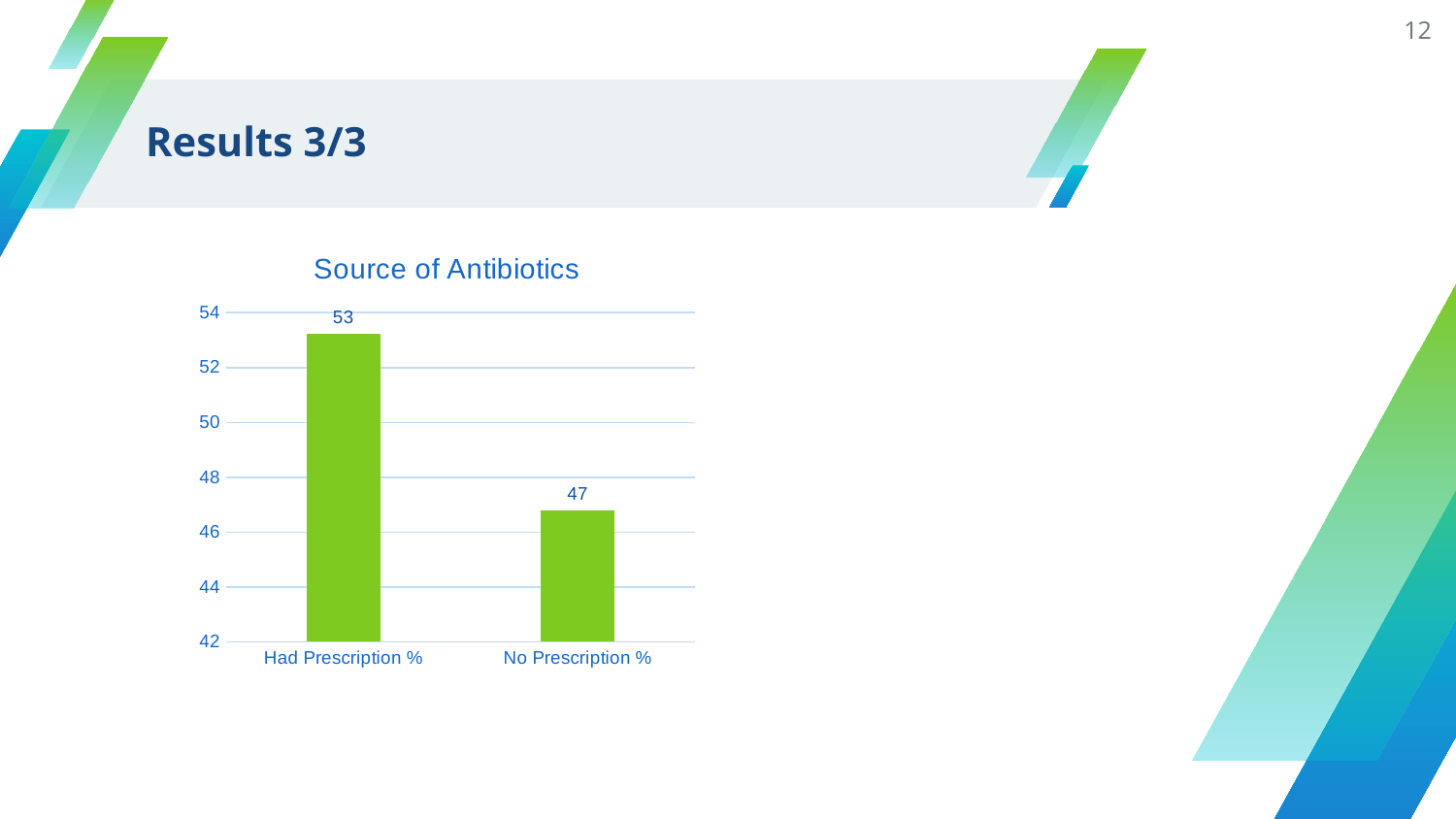
What kind of chart is shown on the slide? bar chart Which category has the lowest value? No Prescription % What is the lowest value shown on the y axis? 42 Which category has the highest value? Had Prescription % What is the value for No Prescription %? 47 Is the value for Had Prescription % greater or less than 50? greater What is the difference between the values for Had Prescription % and No Prescription %? 6 Is the value for No Prescription % greater or less than 48? less What is the title of the chart? Source of Antibiotics How many categories are shown on the x axis? 2 What is the value for Had Prescription %? 53 Which is larger, the value for Had Prescription % or the value for No Prescription %? Had Prescription %